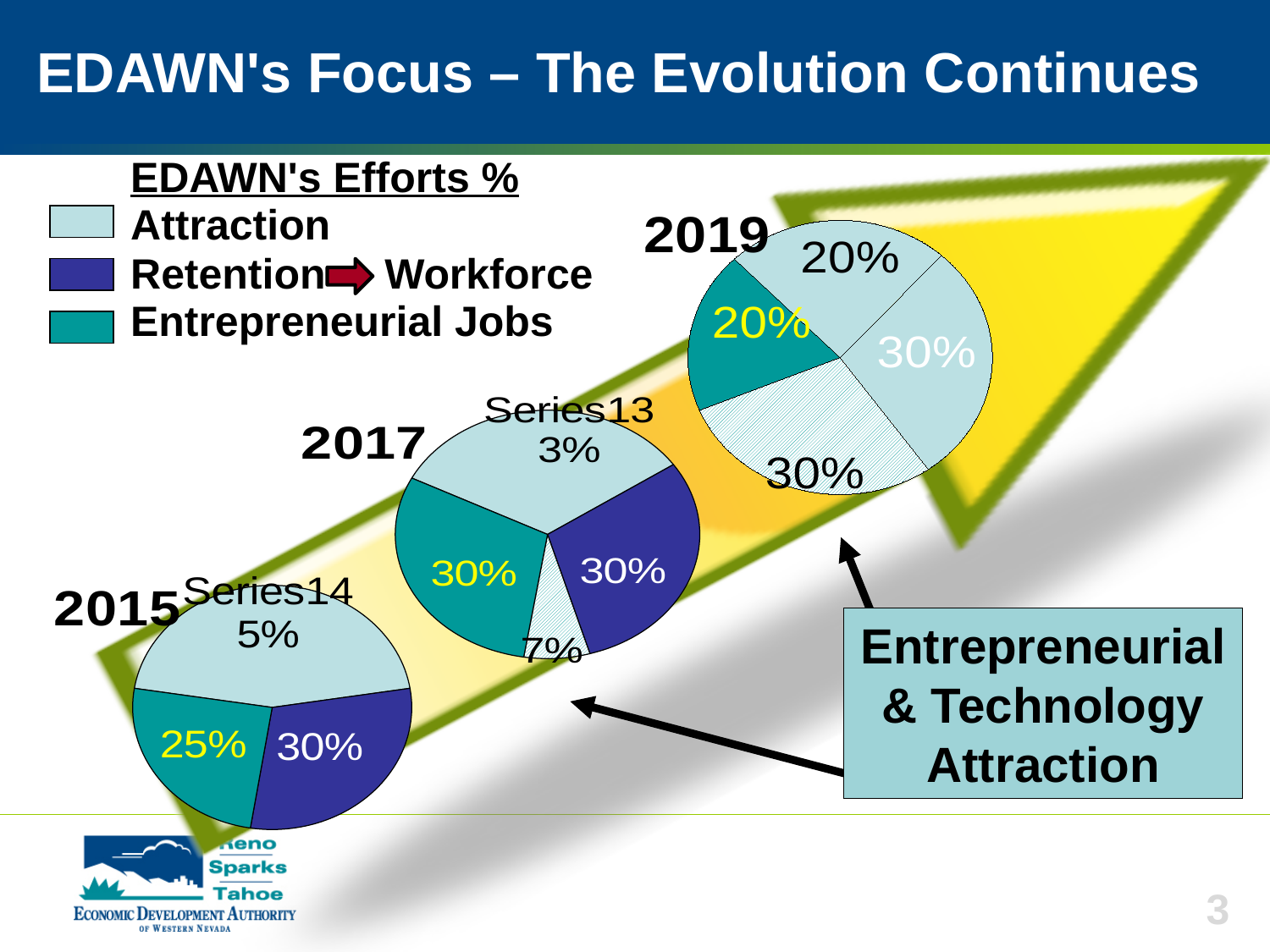
In the 2017 pie chart, what percentage is shown on the small hatched slice at the bottom? 7% Which three years are labelled on the pie charts? 2015, 2017, 2019 What kind of charts are shown on the slide? Pie charts In the 2015 pie chart, what is the difference between the Retention slice (30%) and the Entrepreneurial Jobs slice (25%)? 5% In the 2015 pie chart, what percentage is shown for Retention (dark blue slice)? 30% How many entries does the legend 'EDAWN's Efforts %' list? 3 In the 2017 pie chart, what percentage is shown for Retention (dark blue slice)? 30% In the 2019 pie chart, what percentage is shown for the teal (Entrepreneurial Jobs) slice? 20% In the 2015 pie chart, which is larger: the Retention slice or the Entrepreneurial Jobs slice? Retention How many pie charts are shown on the slide? 3 In the 2017 pie chart, what percentage is shown for Entrepreneurial Jobs (teal slice)? 30% In the 2015 pie chart, what percentage is shown for Entrepreneurial Jobs (teal slice)? 25%